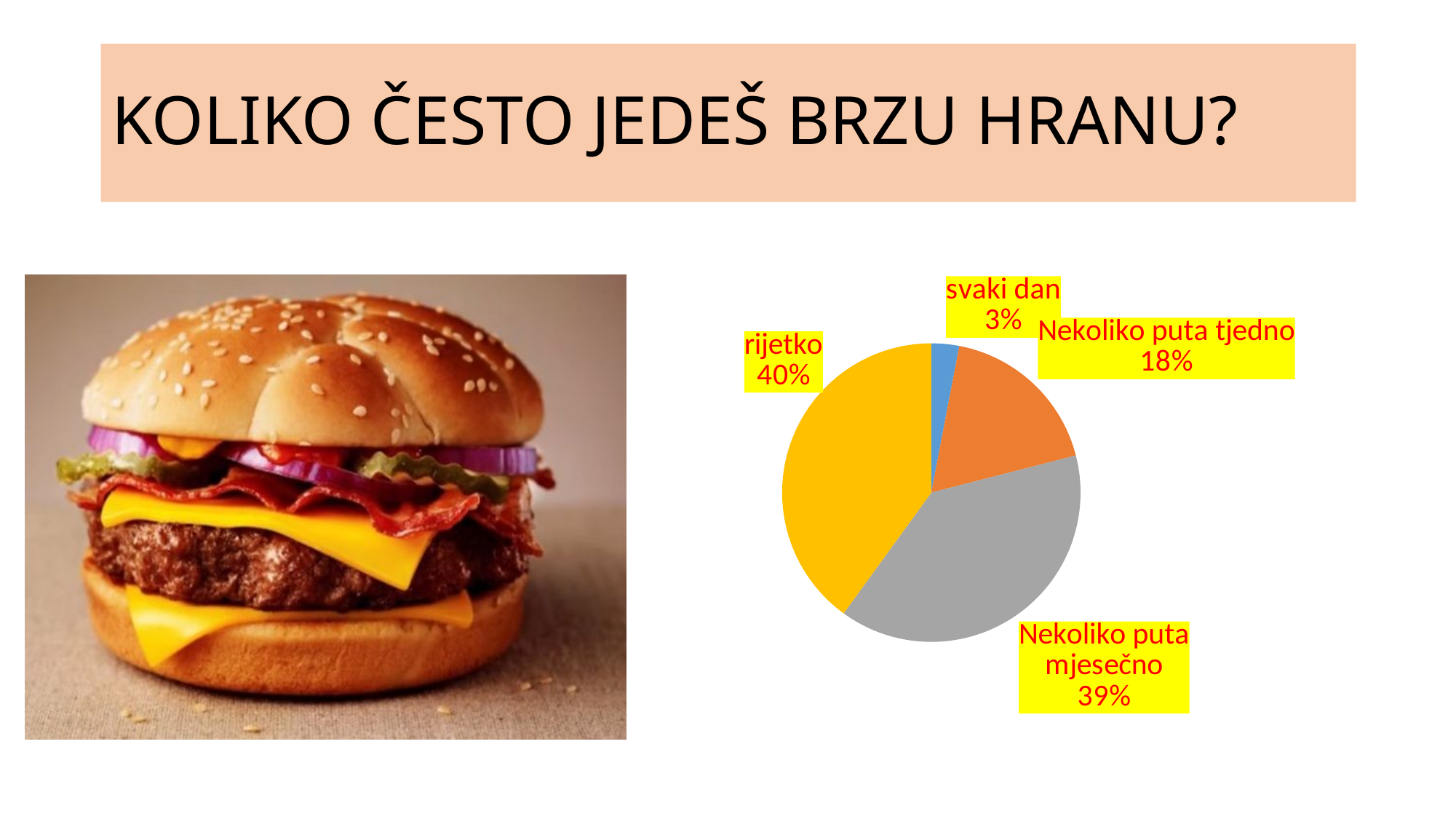
What colour is the slice for "rijetko"? yellow What is the difference in percentage points between "rijetko" and "svaki dan"? 37 Which category has the smallest slice of the pie? svaki dan What share of the pie does "Nekoliko puta mjesečno" have? 39% Which is larger, the slice for "Nekoliko puta tjedno" or the slice for "Nekoliko puta mjesečno"? Nekoliko puta mjesečno What kind of chart is shown on the slide? pie chart What is the difference in percentage points between "Nekoliko puta mjesečno" and "Nekoliko puta tjedno"? 21 How many slices does the pie chart have? 4 Which category has the largest slice of the pie? rijetko What share of the pie does "svaki dan" have? 3% What share of the pie does "rijetko" have? 40% What share of the pie does "Nekoliko puta tjedno" have? 18%